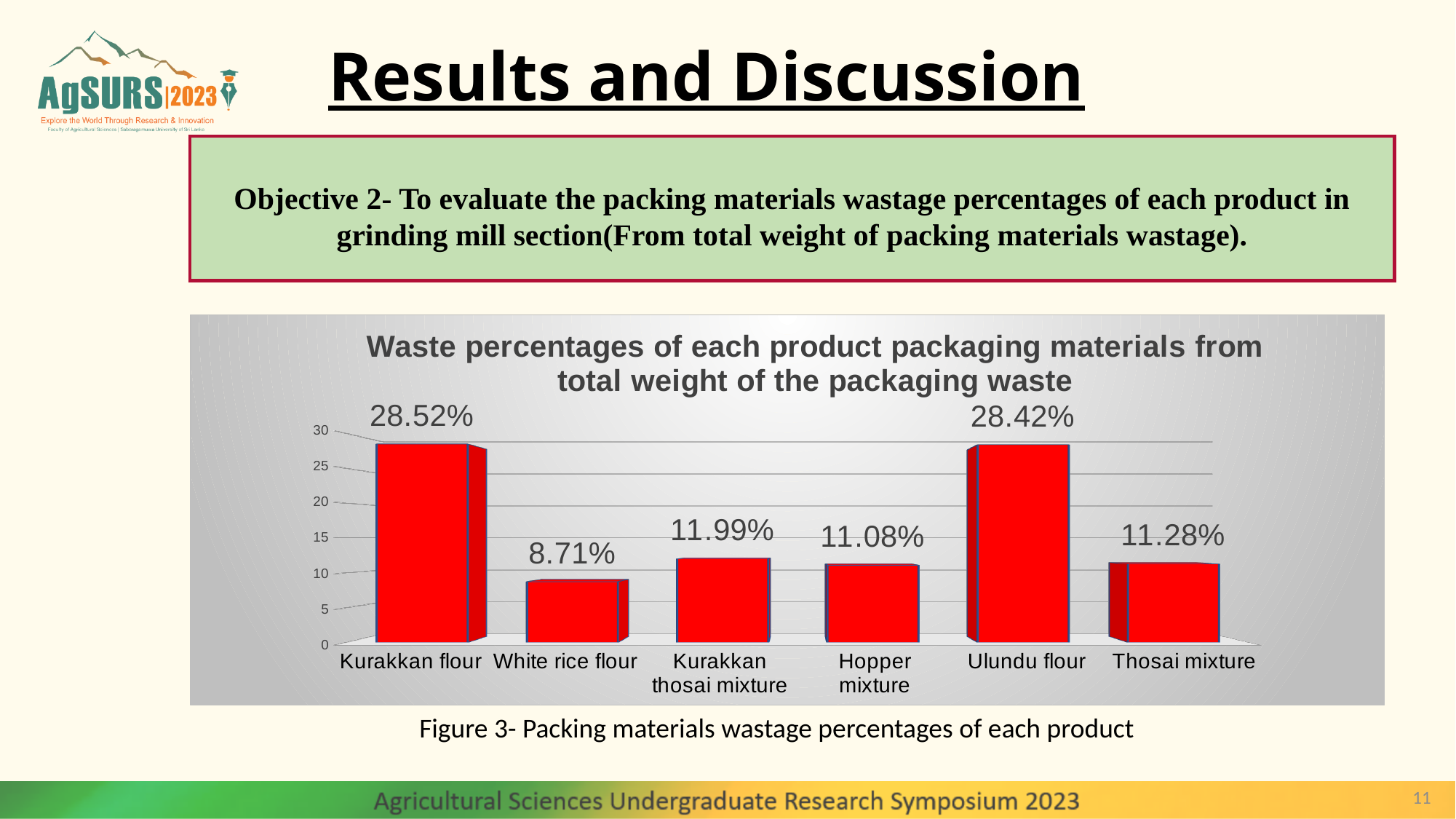
What is the waste percentage for Hopper mixture? 11.08% Which product has the lowest waste percentage? White rice flour What is the waste percentage for Thosai mixture? 11.28% How many products are shown on the chart? 6 What is the waste percentage for Kurakkan flour? 28.52% Which product has the highest waste percentage? Kurakkan flour Which has a larger waste percentage, Kurakkan thosai mixture or Hopper mixture? Kurakkan thosai mixture What is the difference between the waste percentages of Kurakkan thosai mixture and White rice flour? 3.28% What kind of chart is shown on the slide? Bar chart What is the waste percentage for White rice flour? 8.71% What is the title of the chart? Waste percentages of each product packaging materials from total weight of the packaging waste What is the difference between the waste percentages of Kurakkan flour and Ulundu flour? 0.10%